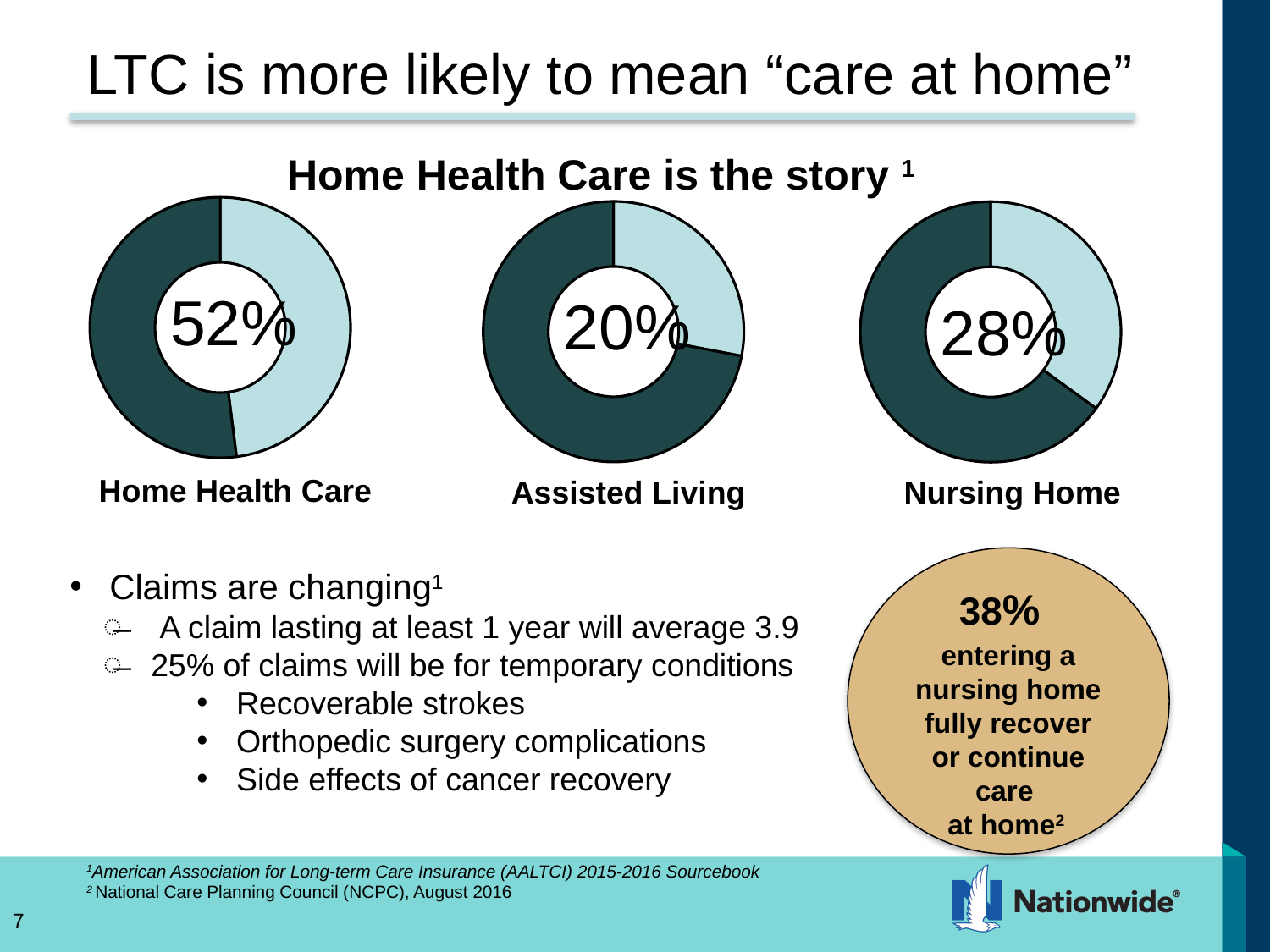
What percentage is shown in the Home Health Care donut chart? 52% What percentage is shown in the Nursing Home donut chart? 28% What percentage is shown in the Assisted Living donut chart? 20% What is the heading above the three donut charts? Home Health Care is the story Which of the three care types has the highest percentage? Home Health Care What kind of chart is used to show the Home Health Care, Assisted Living and Nursing Home percentages? Donut (pie) chart Which is larger, the Nursing Home percentage or the Assisted Living percentage? Nursing Home What is the difference between the Nursing Home percentage and the Assisted Living percentage? 8% How many donut charts are shown on the slide? 3 Which of the three care types has the lowest percentage? Assisted Living What is the difference between the Home Health Care percentage and the Nursing Home percentage? 24% What is the total of the three percentages shown in the donut charts? 100%